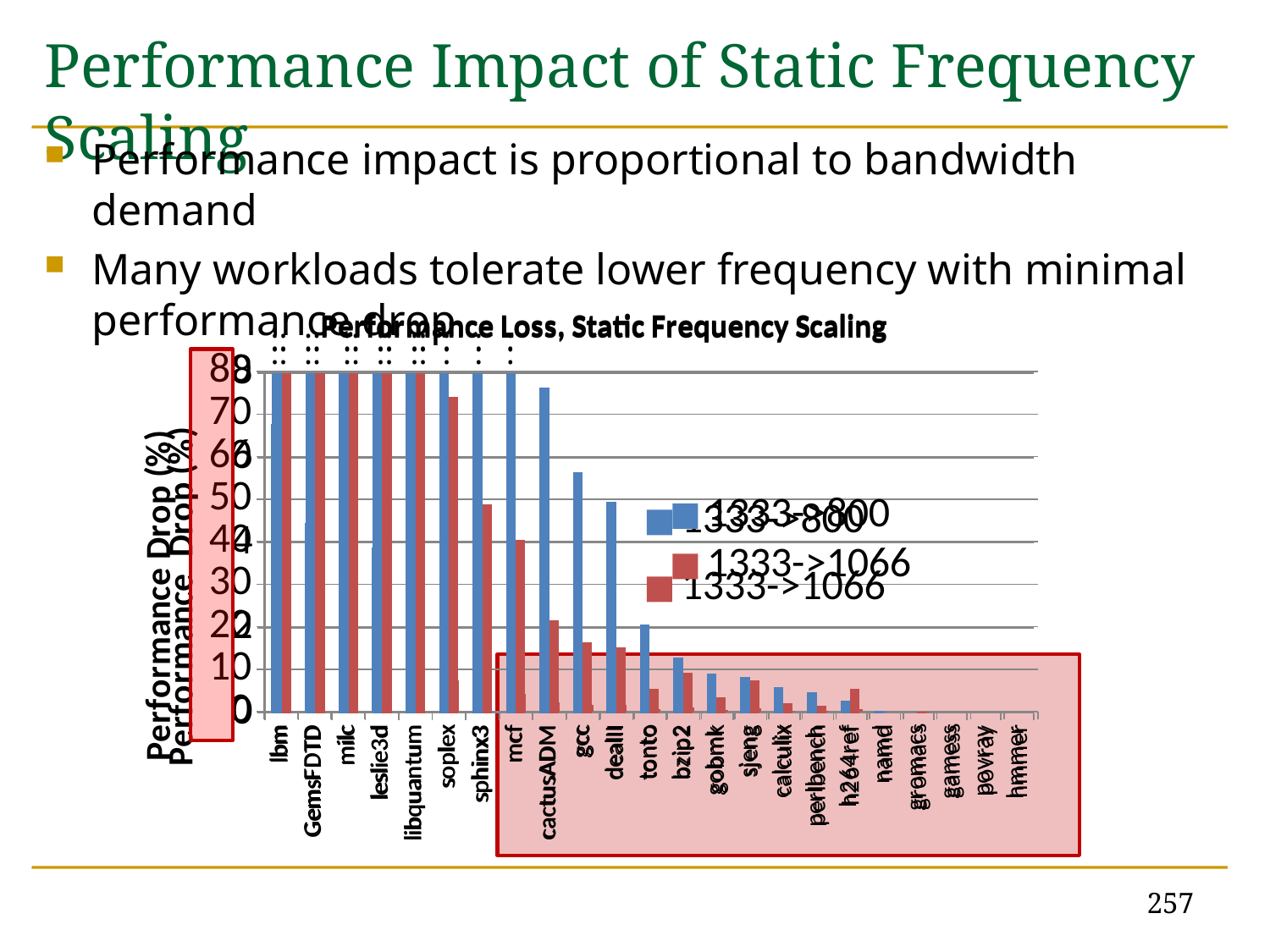
What are the two series named in the chart legend? 1333->800 and 1333->1066 For mcf, which series shows the larger performance drop, 1333->800 or 1333->1066? 1333->800 How many workloads (categories) are shown on the x axis of the chart? 23 Do the performance drop values generally rise or fall moving from left to right along the x axis? fall What kind of chart is shown on the slide? bar chart What is the title of the chart? Performance Loss, Static Frequency Scaling How many series does the chart legend list? 2